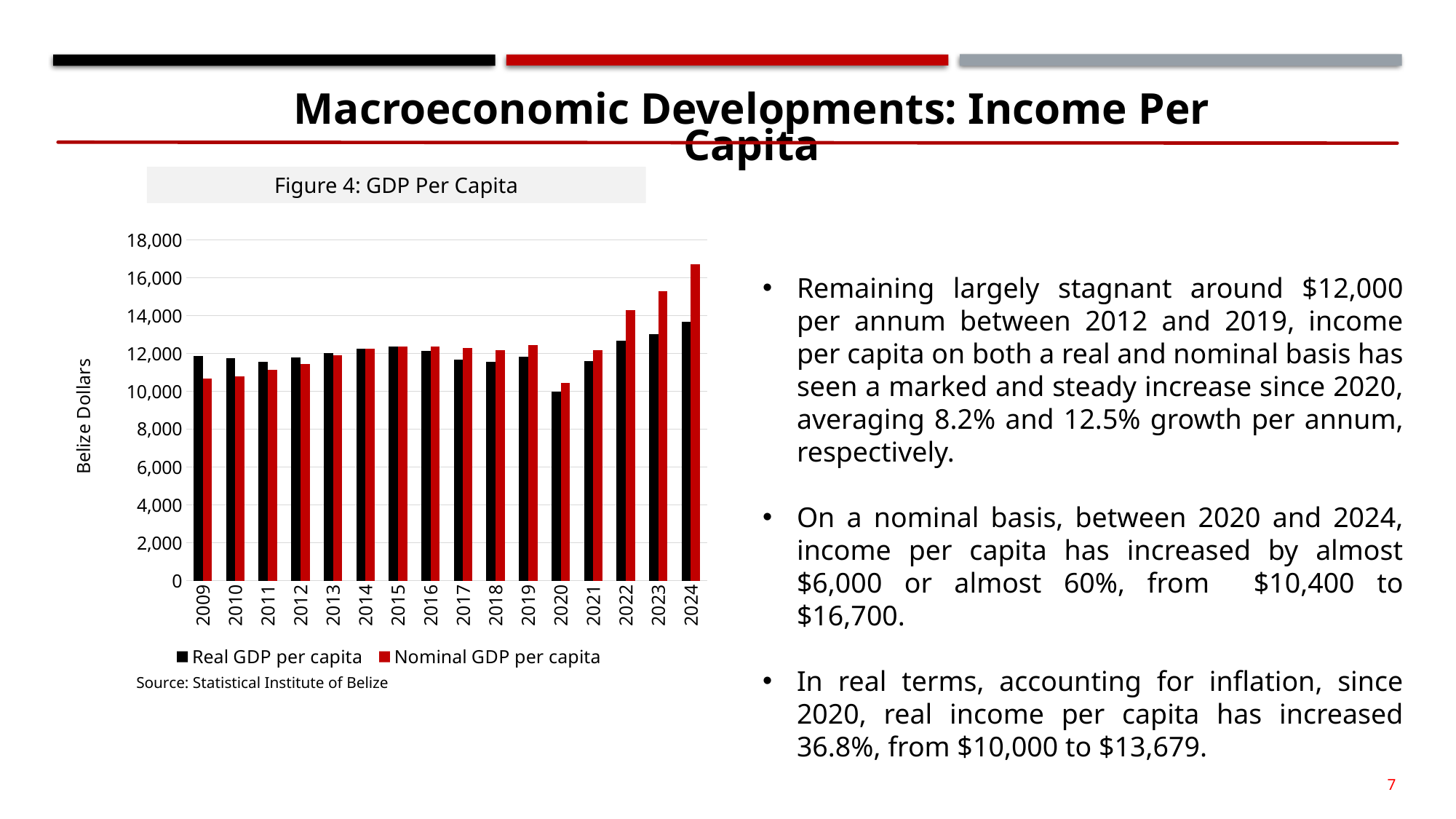
What kind of chart is Figure 4: GDP Per Capita? bar chart Is the Nominal GDP per capita value for 2023 greater or less than 14,000? greater What is the label on the y axis of Figure 4? Belize Dollars How many years are shown on the x axis of Figure 4? 16 Does Nominal GDP per capita rise or fall from 2020 to 2024 in Figure 4? rise In which year is Real GDP per capita lowest in Figure 4? 2020 In which year is Nominal GDP per capita highest in Figure 4? 2024 How many series does the legend of Figure 4 list? 2 In 2009, which is larger in Figure 4: Real GDP per capita or Nominal GDP per capita? Real GDP per capita Is the Real GDP per capita value for 2020 greater or less than 12,000? less Is the Nominal GDP per capita value for 2024 greater or less than 16,000? greater In 2024, which is larger in Figure 4: Real GDP per capita or Nominal GDP per capita? Nominal GDP per capita